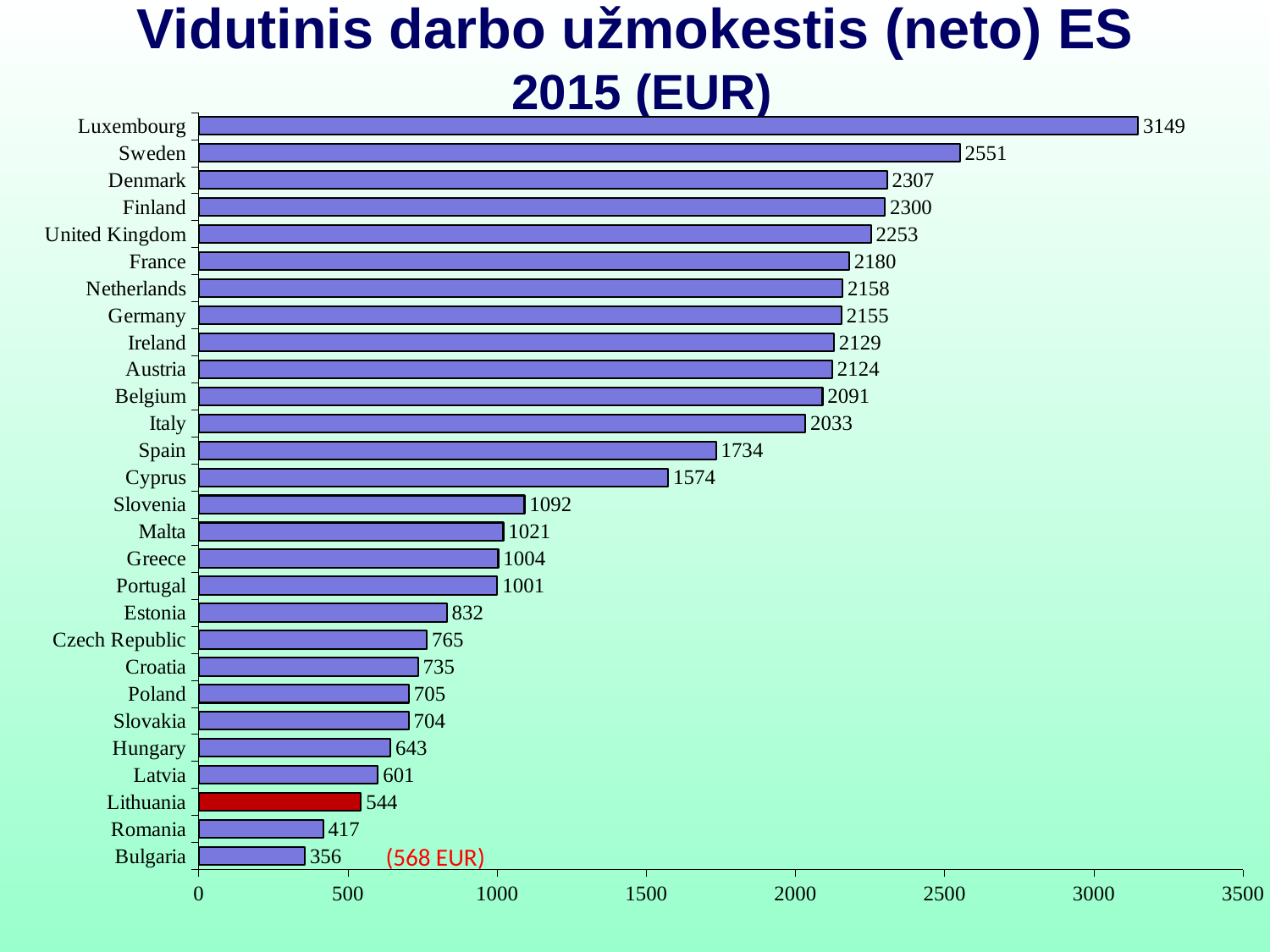
Which country has the highest value? Luxembourg What is the difference between the values for Latvia and Lithuania? 57 Which country's bar is coloured red? Lithuania What is the value for Germany? 2155 What is the value for Estonia? 832 What is the difference between the values for Sweden and Denmark? 244 How many countries are shown in the chart? 28 What kind of chart is shown on the slide? bar chart Which is larger, the value for Spain or the value for Cyprus? Spain Is the value for Slovenia greater or less than 1000? greater What is the value for Lithuania? 544 Which country has the lowest value? Bulgaria